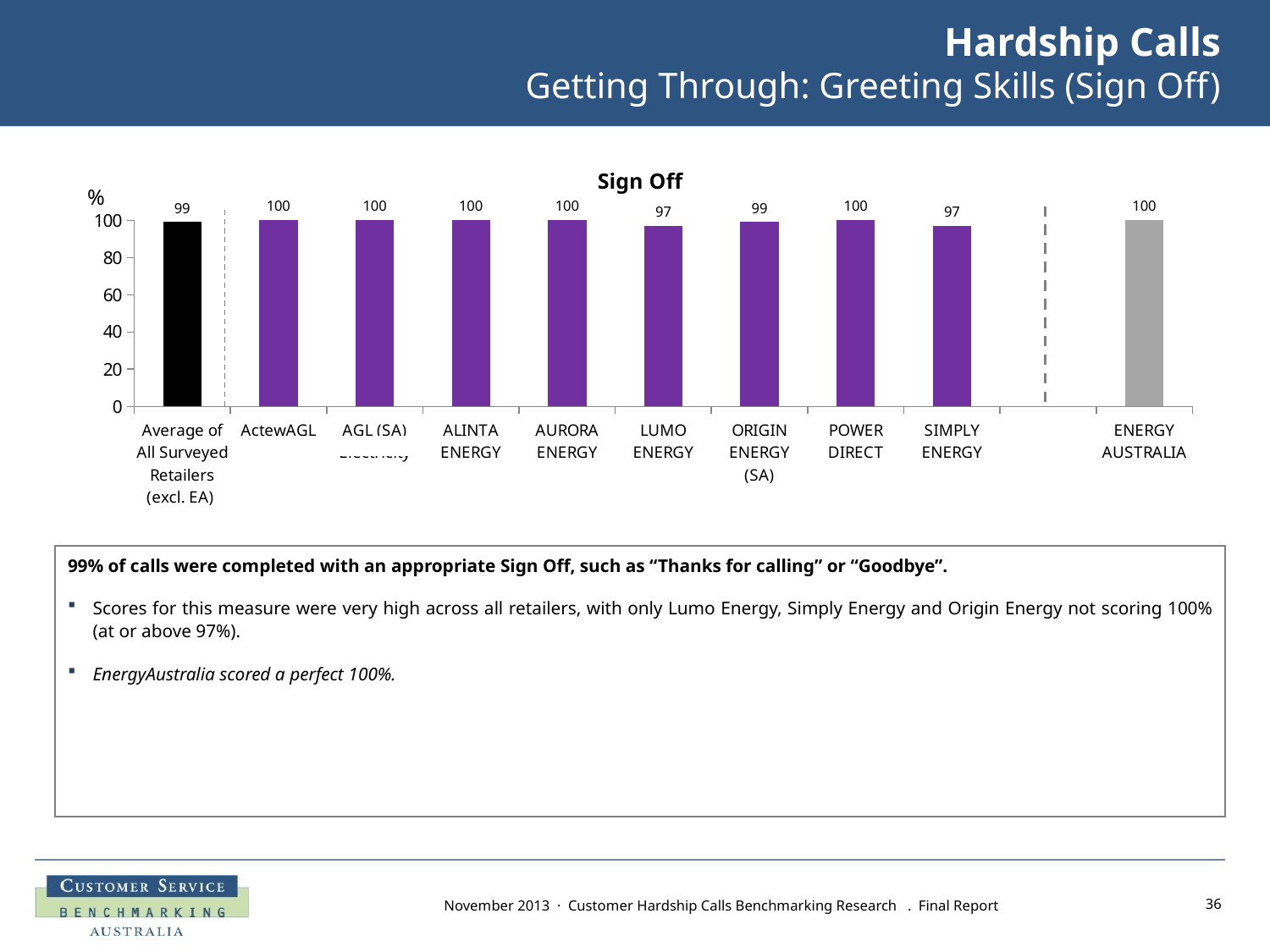
What is the value shown for the Average of All Surveyed Retailers (excl. EA)? 99 Which has a higher Sign Off score, AURORA ENERGY or SIMPLY ENERGY? AURORA ENERGY What score does ORIGIN ENERGY (SA) have on the Sign Off chart? 99 How many bars are plotted on the Sign Off chart? 10 What type of chart is shown on the slide? Bar chart What colour is the bar for ENERGY AUSTRALIA? Grey Is the value for ActewAGL greater or less than 80? greater What is the difference between the scores for POWER DIRECT and LUMO ENERGY? 3 What is the value for SIMPLY ENERGY? 97 What is the Sign Off score for ENERGY AUSTRALIA? 100 What is the Sign Off score for LUMO ENERGY? 97 What is the title of the chart? Sign Off